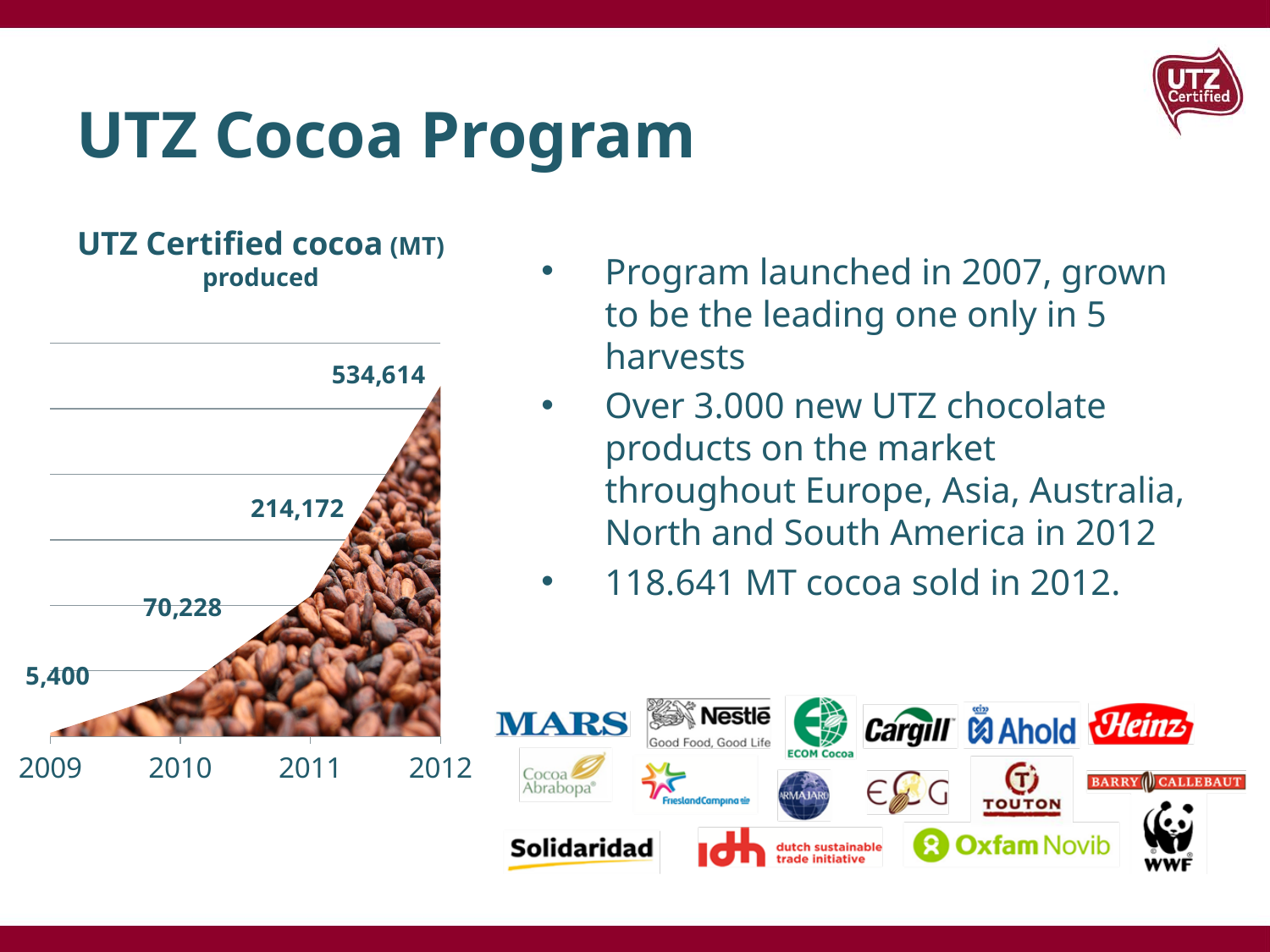
What was the UTZ Certified cocoa produced in 2010? 70,228 Which year had the lowest UTZ Certified cocoa production? 2009 Which year had the highest UTZ Certified cocoa production? 2012 Which year had more UTZ Certified cocoa produced, 2010 or 2011? 2011 Does UTZ Certified cocoa production rise or fall from 2009 to 2012? rise By how much did UTZ Certified cocoa production increase from 2011 to 2012? 320,442 What is the difference in UTZ Certified cocoa produced between 2010 and 2011? 143,944 What unit is given in the chart title for UTZ Certified cocoa produced? MT How many years are shown on the x axis of the chart? 4 What was the UTZ Certified cocoa produced in 2012? 534,614 What was the UTZ Certified cocoa produced in 2011? 214,172 What was the UTZ Certified cocoa produced in 2009? 5,400